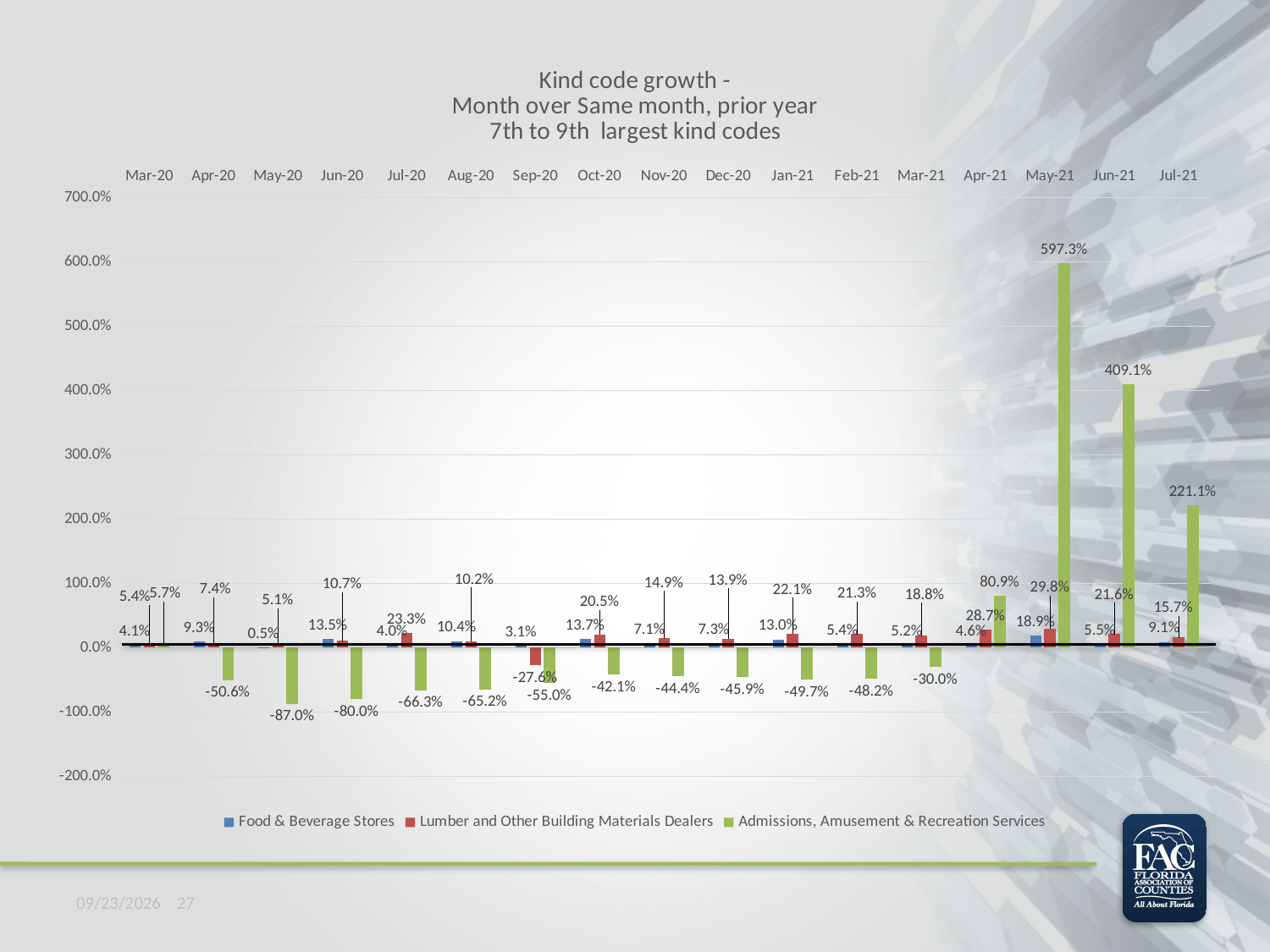
What kind of chart is shown on the slide? Bar chart Which is larger for Admissions, Amusement & Recreation Services: the value in Apr-21 or the value in Jul-21? Jul-21 What is the value for Admissions, Amusement & Recreation Services in May-21? 597.3% What is the value for Admissions, Amusement & Recreation Services in Jul-21? 221.1% In which month does Admissions, Amusement & Recreation Services reach its highest value? May-21 In which month does Admissions, Amusement & Recreation Services reach its lowest value? May-20 What is the value for Admissions, Amusement & Recreation Services in May-20? -87.0% What is the value for Admissions, Amusement & Recreation Services in Jun-21? 409.1% How many months are shown on the x axis? 17 How many series does the legend list? 3 Is the value for Admissions, Amusement & Recreation Services in Jun-21 greater or less than 400.0%? greater What is the difference between the Admissions, Amusement & Recreation Services values in May-21 and Jun-21? 188.2 percentage points